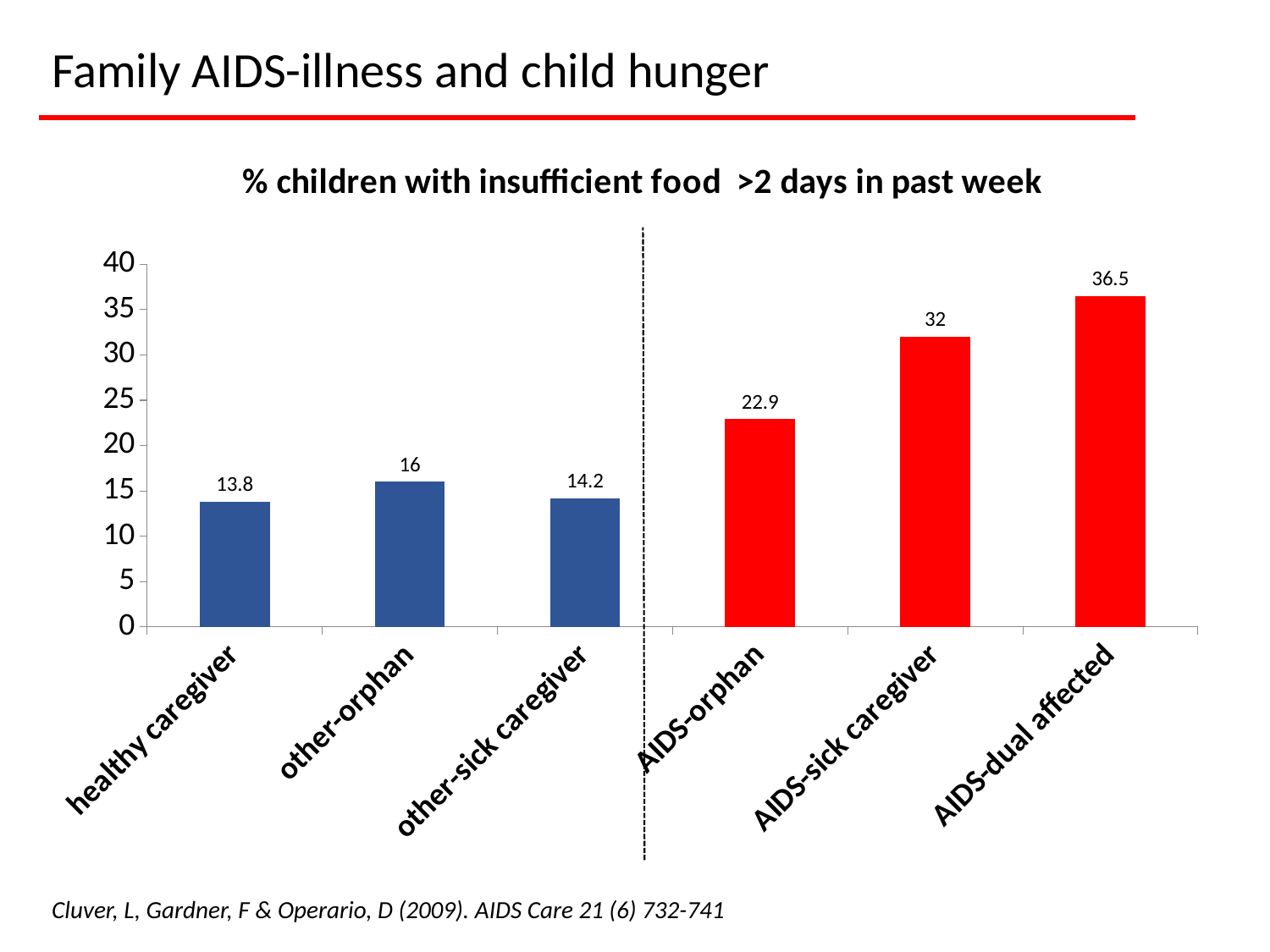
What is the value for other-orphan? 16 What is the difference between the values for AIDS-orphan and other-orphan? 6.9 Which is larger, the value for other-sick caregiver or the value for AIDS-sick caregiver? AIDS-sick caregiver Is the value for AIDS-orphan greater or less than 20? greater What is the difference between the values for AIDS-dual affected and healthy caregiver? 22.7 What is the value for AIDS-sick caregiver? 32 Which category has the lowest value? healthy caregiver What is the title of the chart? % children with insufficient food >2 days in past week Which category has the highest value? AIDS-dual affected How many categories are shown on the x axis? 6 What kind of chart is shown on the slide? bar chart What is the value for healthy caregiver? 13.8